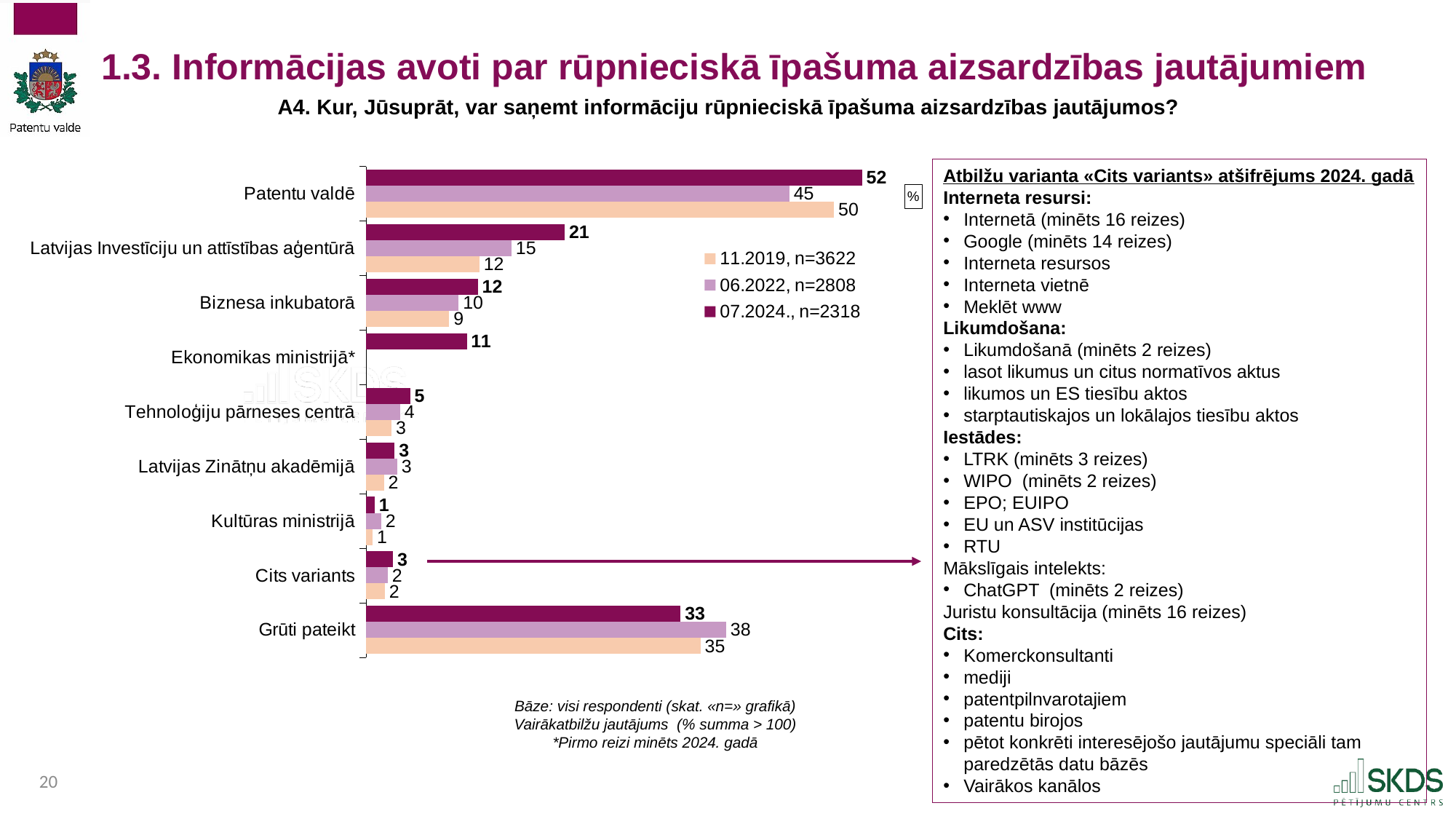
What kind of chart is shown on the slide? bar chart What is the value for Patentu valdē in the 07.2024 series? 52 What is the sample size (n) shown in the legend for the 07.2024 series? n=2318 For Grūti pateikt, which series has the larger value: 11.2019 or 07.2024? 11.2019 Which category has the lowest value in the 07.2024 series? Kultūras ministrijā What is the value for Grūti pateikt in the 06.2022 series? 38 Which category has the highest value in the 07.2024 series? Patentu valdē What is the value for Latvijas Investīciju un attīstības aģentūrā in the 11.2019 series? 12 What is the value for Ekonomikas ministrijā* in the 07.2024 series? 11 How many categories are shown on the chart's vertical axis? 9 How many series does the chart legend list? 3 What is the difference between the 07.2024 and 06.2022 values for Latvijas Investīciju un attīstības aģentūrā? 6